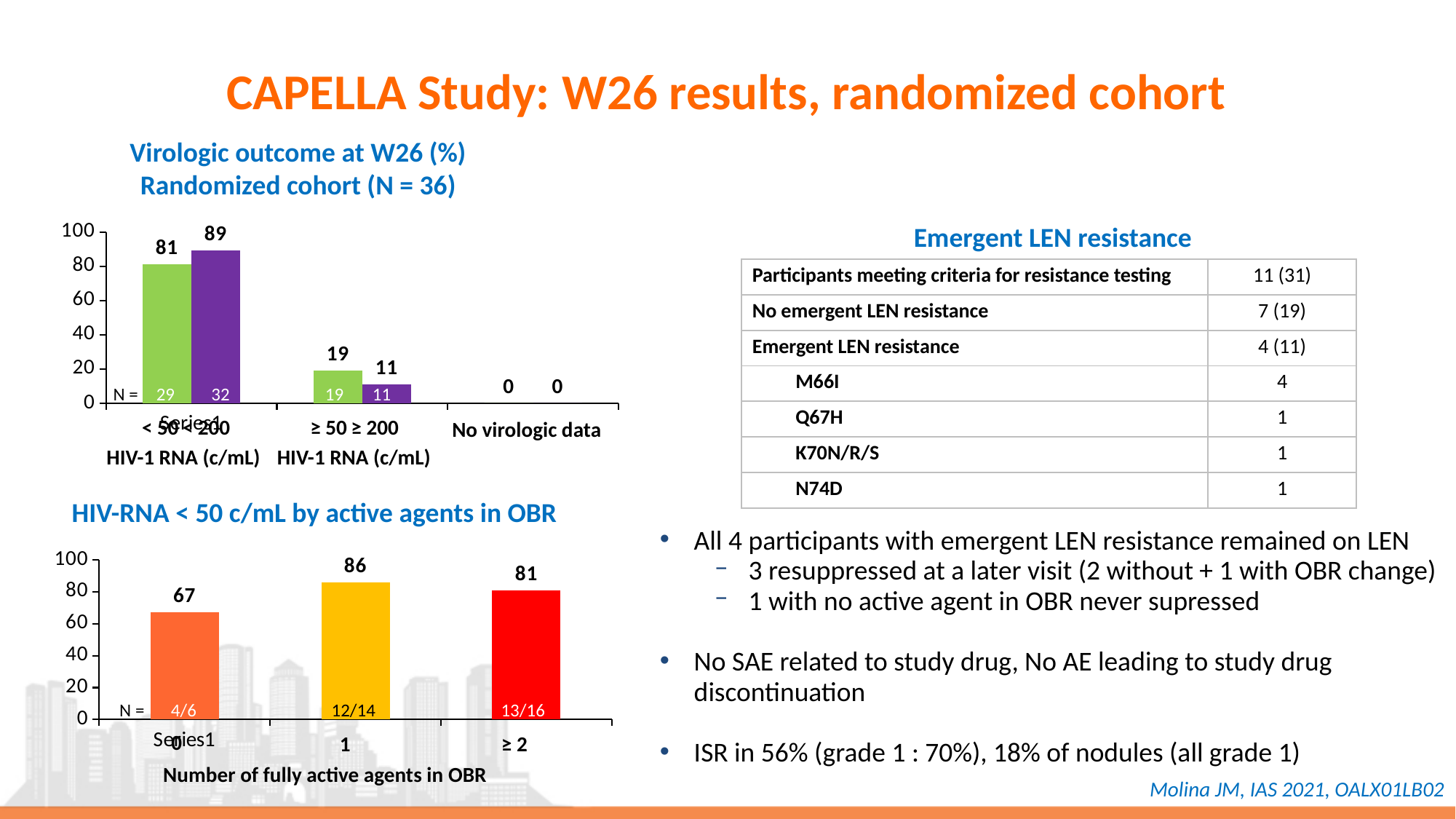
In the 'HIV-RNA < 50 c/mL by active agents in OBR' chart, how many categories are shown on the x axis? 3 In the 'HIV-RNA < 50 c/mL by active agents in OBR' chart, what is the value for 0 fully active agents in OBR? 67 In the 'HIV-RNA < 50 c/mL by active agents in OBR' chart, what N is shown for the ≥ 2 category? 13/16 In the 'Virologic outcome at W26 (%)' chart, what is the difference between the green bar (< 50) and the purple bar (< 200)? 8 In the 'HIV-RNA < 50 c/mL by active agents in OBR' chart, which category has the highest value? 1 In the 'HIV-RNA < 50 c/mL by active agents in OBR' chart, what is the difference between the values for 1 and ≥ 2 fully active agents? 5 In the 'Virologic outcome at W26 (%)' chart, what is the value of the purple bar for HIV-1 RNA < 200 c/mL? 89 In the 'HIV-RNA < 50 c/mL by active agents in OBR' chart, what is the value for 1 fully active agent in OBR? 86 In the 'HIV-RNA < 50 c/mL by active agents in OBR' chart, which category has the lowest value? 0 In the 'Virologic outcome at W26 (%)' chart, what is the value of the green bar for HIV-1 RNA < 50 c/mL? 81 In the 'Virologic outcome at W26 (%)' chart, what is the value shown for 'No virologic data'? 0 What kind of chart is the 'Virologic outcome at W26 (%)' chart? Bar chart